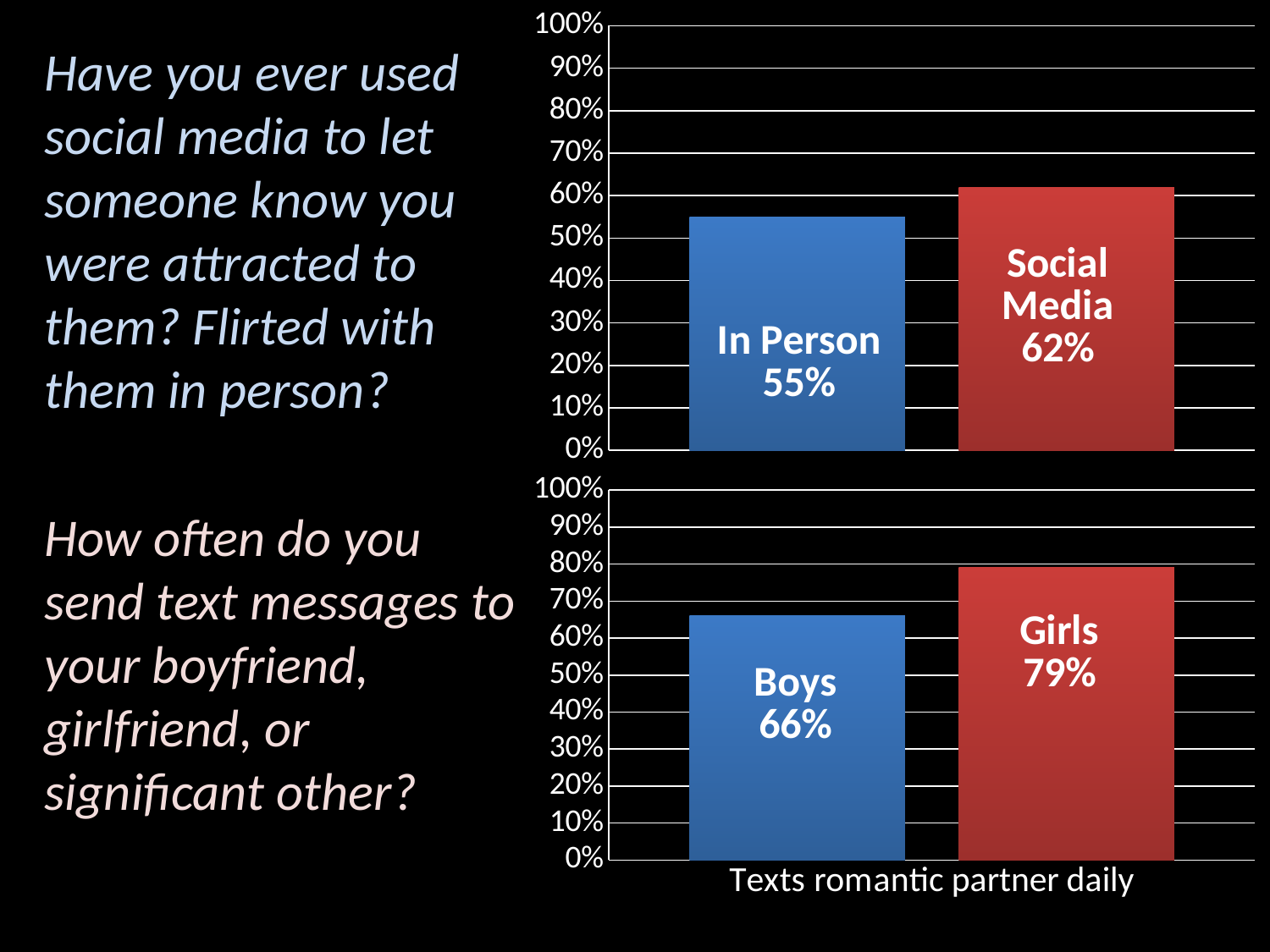
In the top chart, what is the difference between the Social Media and In Person values? 7% In the top chart, what is the value for Social Media? 62% How many bars are in the top chart? 2 In the bottom chart, which category has the lower value? Boys In the bottom chart, what is the value for Girls? 79% What kind of chart is the bottom chart? bar chart In the bottom chart, what is the value for Boys? 66% In the top chart, which category has the higher value? Social Media In the top chart, what is the value for In Person? 55% What is the x-axis label of the bottom chart? Texts romantic partner daily In the bottom chart, is the value for Girls greater or less than 70%? greater In the bottom chart, what is the difference between the Girls and Boys values? 13%